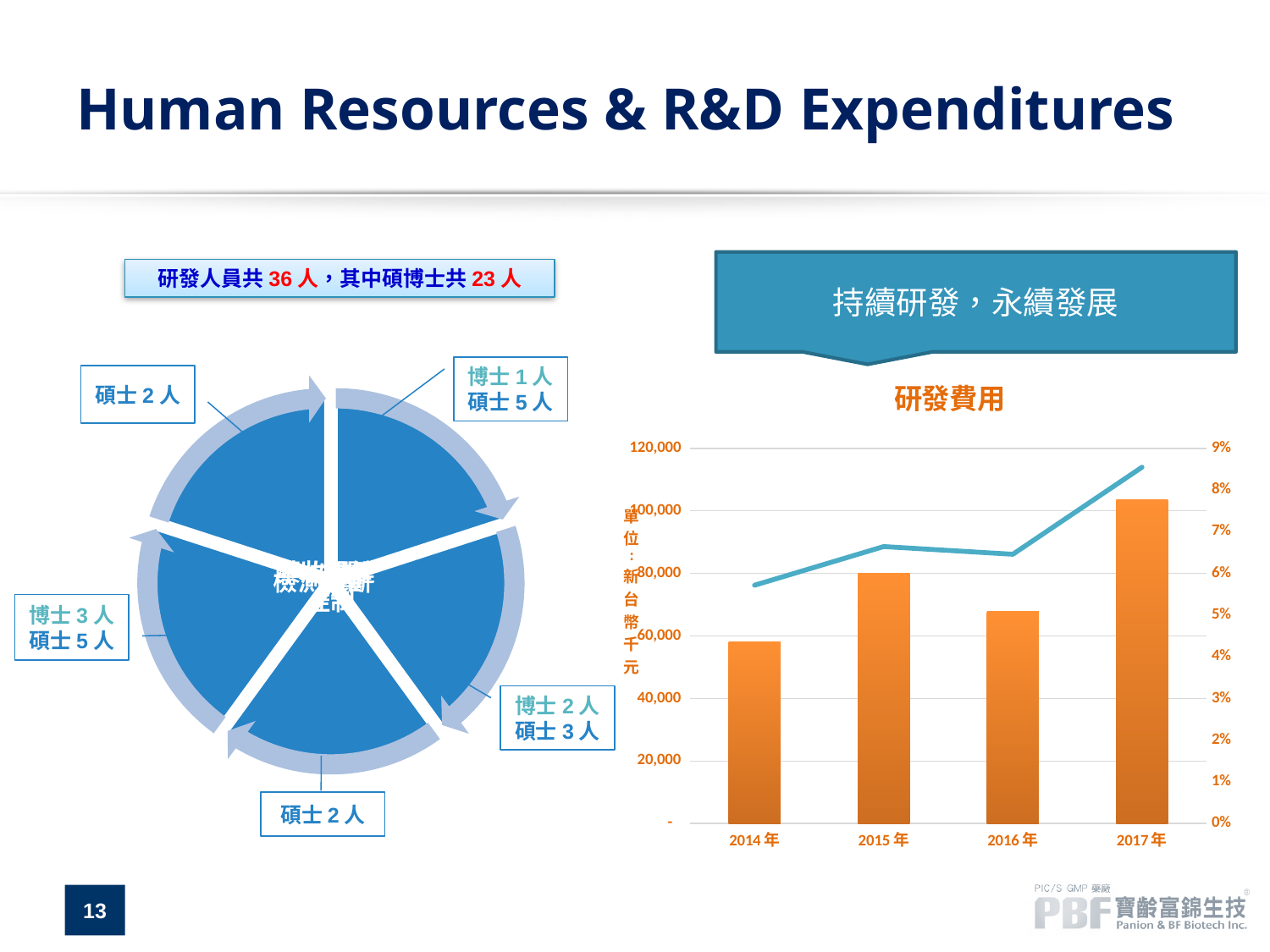
In the 研發費用 chart, which year has the shortest bar? 2014年 In the 研發費用 chart, is the bar value for 2016年 greater or less than 60,000? greater In the 研發費用 chart, does the line generally rise or fall from 2014年 to 2017年? Rise What kind of chart is the 研發費用 chart? A bar chart combined with a line chart What is the title of the chart on the right side of the slide? 研發費用 In the 研發費用 chart, is the bar value for 2017年 greater or less than 120,000? less How many years are shown on the x axis of the 研發費用 chart? 4 In the 研發費用 chart, is the line value for 2017年 greater or less than 8%? greater In the 研發費用 chart, which bar is taller, 2015年 or 2016年? 2015年 In the 研發費用 chart, in which year does the line reach its highest point? 2017年 In the 研發費用 chart, which year has the tallest bar? 2017年